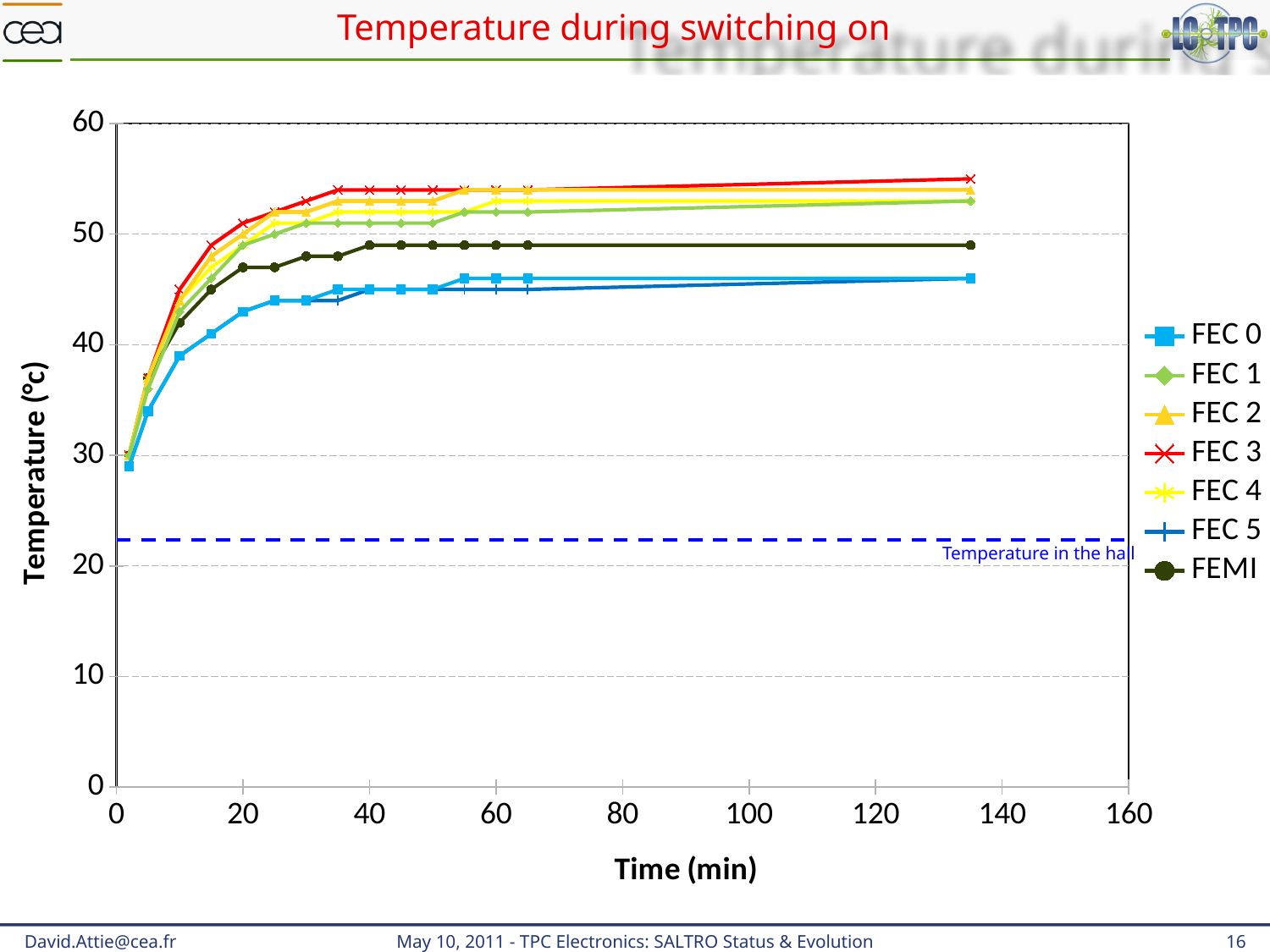
Do the temperatures of the FEC series rise or fall as time increases? Rise At 40 min, which is higher: FEMI or FEC 0? FEMI What is the title of the chart? Temperature during switching on What kind of chart is shown on the slide? Line chart Is the dashed 'Temperature in the hall' line greater or less than 30? less Is the temperature of FEC 3 at 135 min greater or less than 50? greater Is the temperature of FEC 0 at 135 min greater or less than 50? less At 135 min, which is higher: FEC 3 or FEC 0? FEC 3 What is the label of the y axis? Temperature (°c) How many series does the legend list? 7 Which series has the highest temperature at 135 min? FEC 3